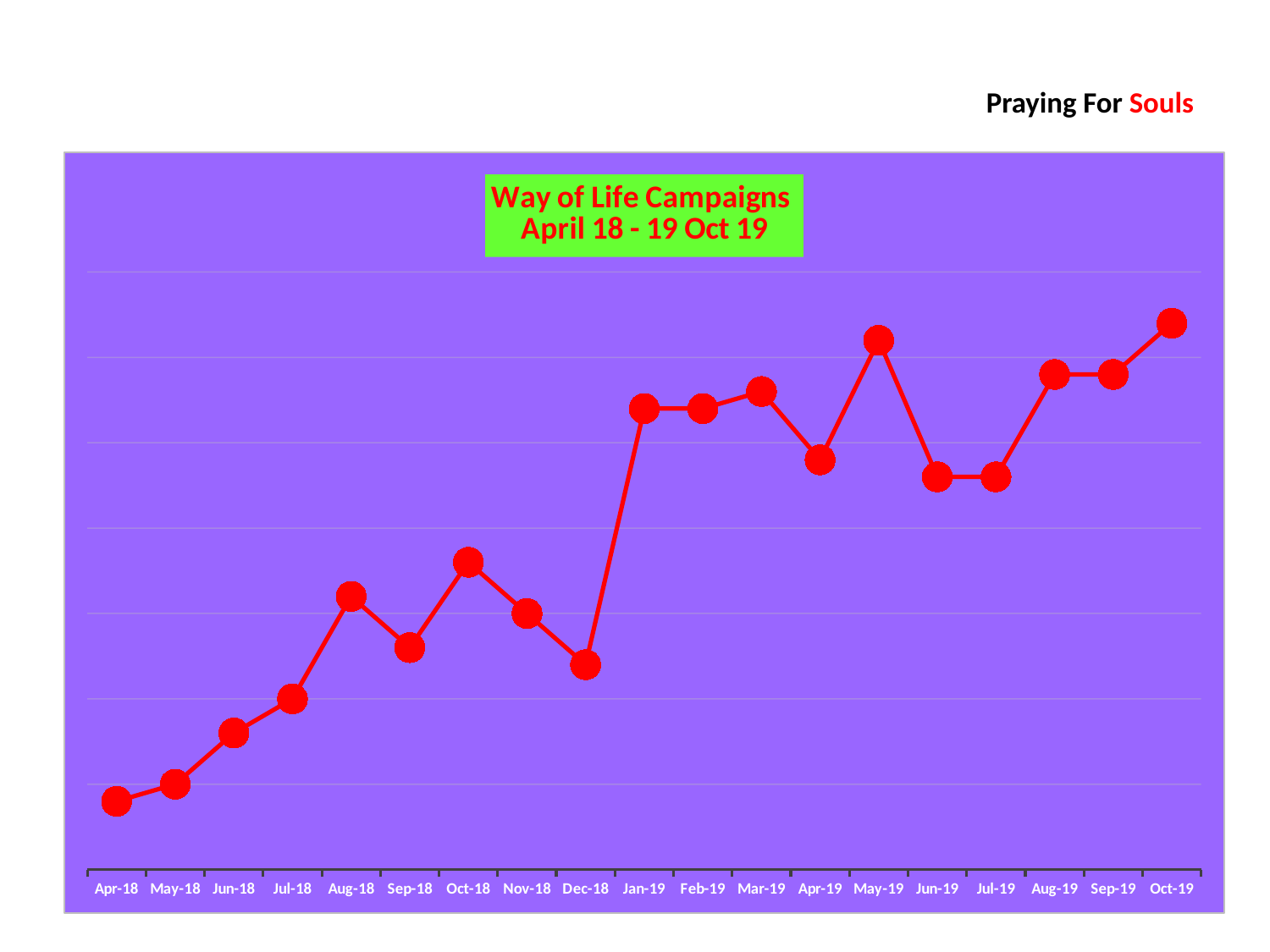
What is the title of the chart? Way of Life Campaigns April 18 - 19 Oct 19 Which is larger, the value for Aug-18 or the value for Sep-18? Aug-18 Which month has the lowest value on the chart? Apr-18 Which month has the highest value on the chart? Oct-19 What colour is the plotted line on the chart? Red Which is larger, the value for Apr-19 or the value for May-19? May-19 How many data points are plotted on the chart? 19 What kind of chart is shown on the slide? Line chart Overall, do the values rise or fall from Apr-18 to Oct-19? Rise Which is larger, the value for Oct-18 or the value for Nov-18? Oct-18